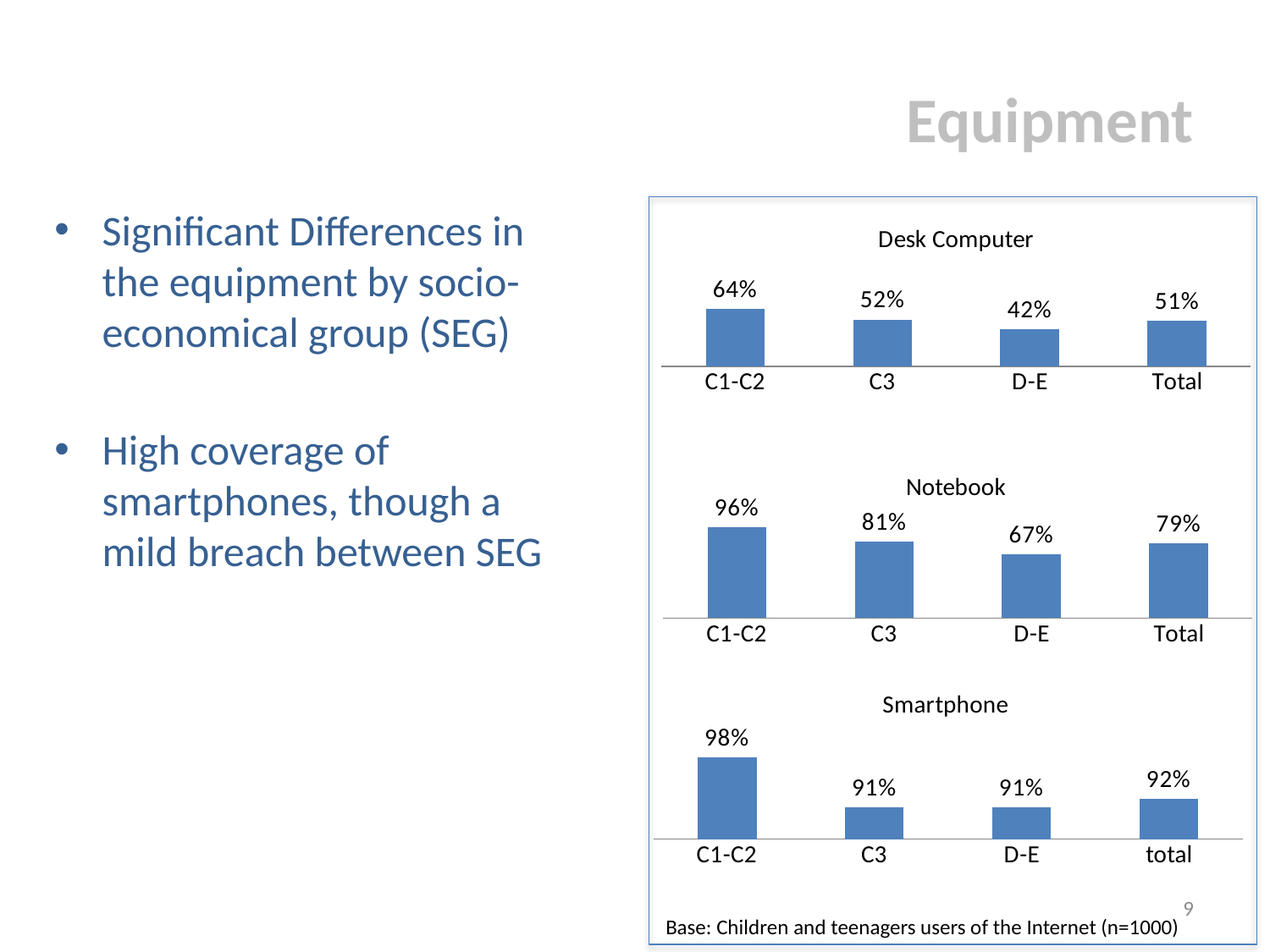
In the Smartphone chart, how many categories are shown? 4 How many charts are shown on the slide? 3 In the Desk Computer chart, do the values rise or fall from C1-C2 to D-E? Fall In the Notebook chart, which category has the highest value? C1-C2 In the Smartphone chart, which is larger, the value for C1-C2 or the value for C3? C1-C2 What kind of chart is the Notebook chart? Bar chart In the Smartphone chart, what is the value for total? 92% In the Desk Computer chart, what is the difference between the C1-C2 and D-E values? 22% In the Notebook chart, what is the value for C3? 81% In the Notebook chart, what is the difference between the Total and D-E values? 12% In the Desk Computer chart, what is the value for C1-C2? 64% In the Desk Computer chart, which category has the lowest value? D-E